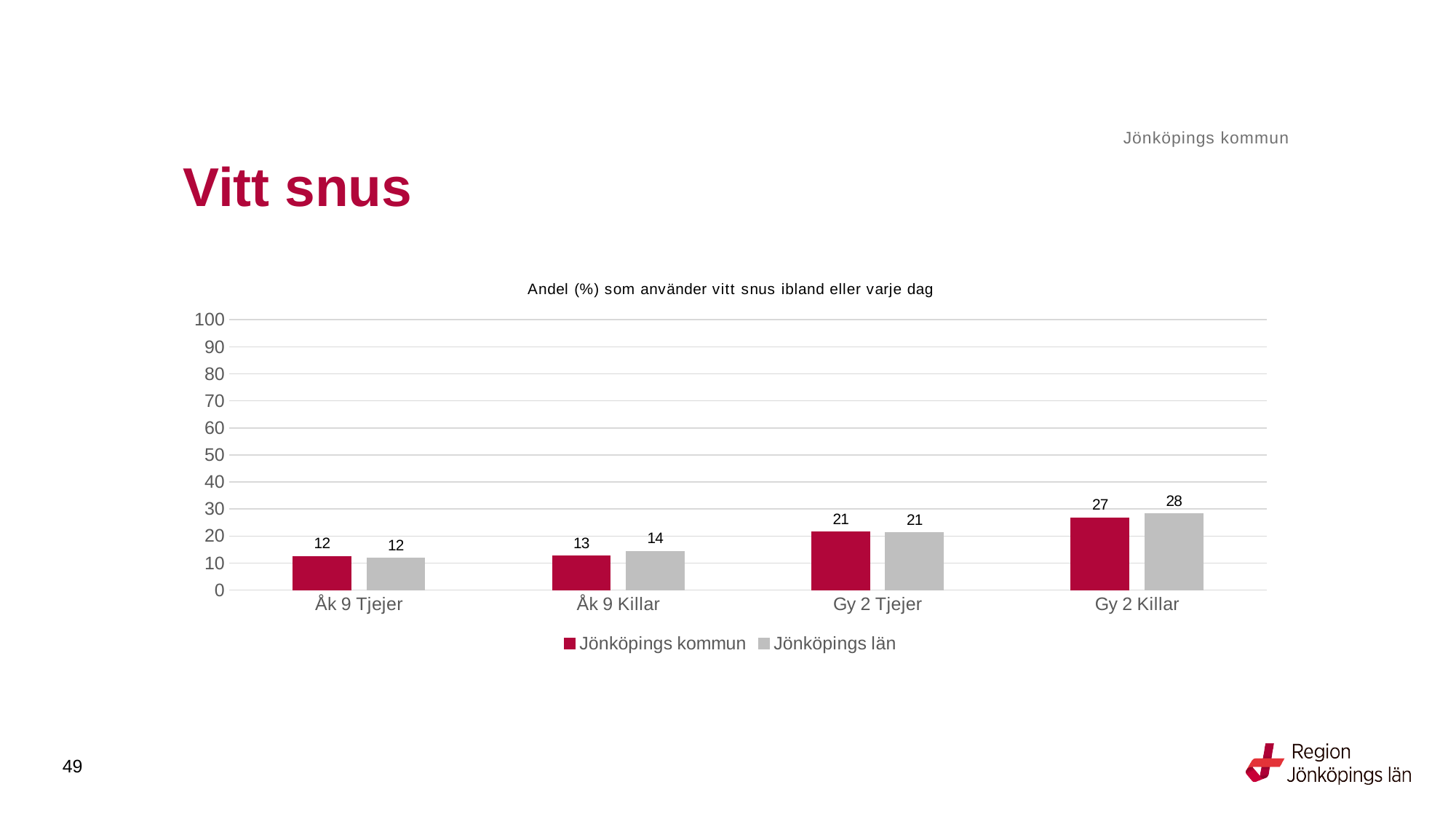
What kind of chart is shown on the slide? Bar chart How many series does the legend list? 2 What is the value for Jönköpings kommun in the Åk 9 Tjejer category? 12 Which category has the lowest value for Jönköpings kommun? Åk 9 Tjejer Which is larger: the Jönköpings län value for Gy 2 Tjejer or for Åk 9 Killar? Gy 2 Tjejer What is the value for Jönköpings län in the Åk 9 Killar category? 14 What is the difference between the Jönköpings kommun values for Gy 2 Killar and Åk 9 Tjejer? 15 Which category has the highest value for Jönköpings län? Gy 2 Killar What is the value for Jönköpings kommun in the Gy 2 Killar category? 27 What is the title of the chart? Andel (%) som använder vitt snus ibland eller varje dag How many categories are shown on the x axis? 4 Is the value for Jönköpings län in Gy 2 Killar greater or less than 20? greater